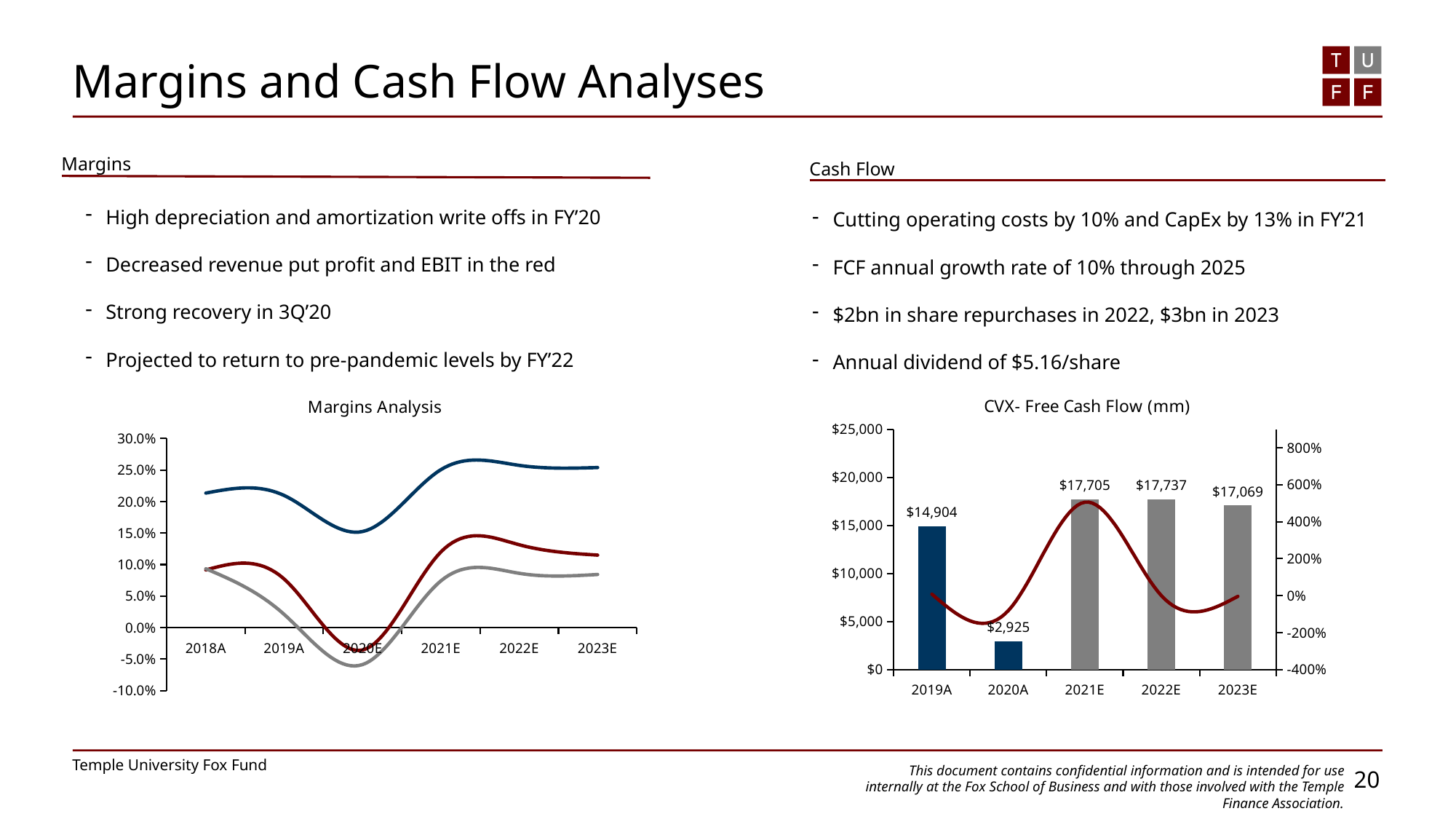
In the CVX- Free Cash Flow (mm) chart, what is the value for 2023E? $17,069 In the CVX- Free Cash Flow (mm) chart, which year has the lowest free cash flow? 2020A In the CVX- Free Cash Flow (mm) chart, how many years are shown on the x axis? 5 In the Margins Analysis chart, how many years are shown on the x axis? 6 In the Margins Analysis chart, is the value of the blue line for 2020E greater or less than 20.0%? less In the CVX- Free Cash Flow (mm) chart, which is larger, the value for 2019A or the value for 2023E? 2023E In the CVX- Free Cash Flow (mm) chart, which year has the highest free cash flow? 2022E What kind of chart is the Margins Analysis chart? Line chart In the CVX- Free Cash Flow (mm) chart, what is the value for 2019A? $14,904 What kind of chart is the CVX- Free Cash Flow (mm) chart? Bar chart with a line In the CVX- Free Cash Flow (mm) chart, what is the value for 2020A? $2,925 In the CVX- Free Cash Flow (mm) chart, what is the difference between the 2021E and 2020A values? $14,780